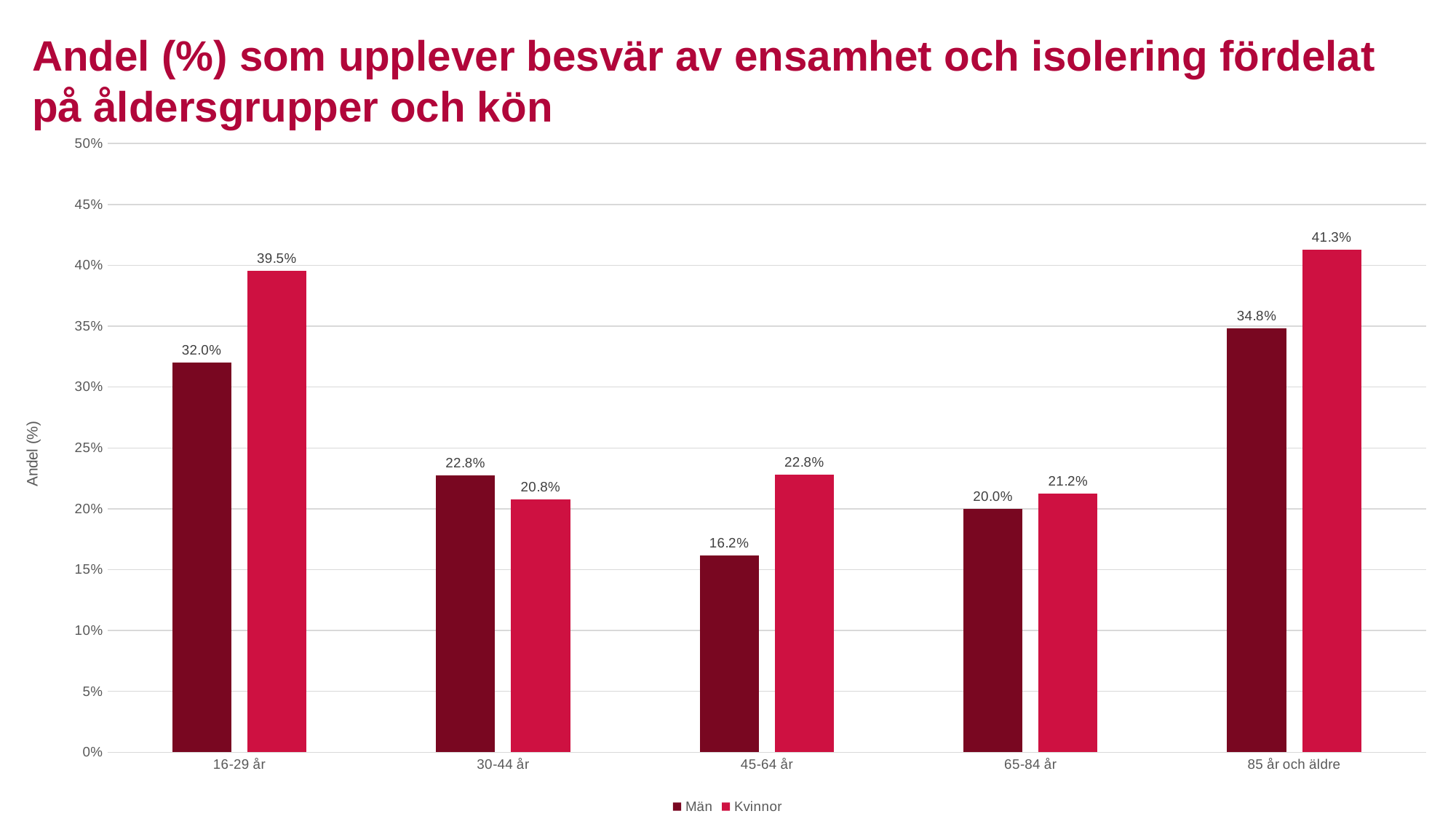
Which is larger in the 30-44 år age group, Män or Kvinnor? Män Which age group has the lowest value for Män? 45-64 år Which age group has the highest value for Kvinnor? 85 år och äldre What is the label of the y axis? Andel (%) How many age groups are shown on the x axis? 5 What is the value for Kvinnor in the 85 år och äldre age group? 41.3% What is the value for Män in the 16-29 år age group? 32.0% What kind of chart is shown on the slide? Bar chart How many series does the legend list? 2 What is the value for Kvinnor in the 45-64 år age group? 22.8% What is the difference between Kvinnor and Män in the 16-29 år age group? 7.5% Is the value for Män in the 85 år och äldre age group greater or less than 30%? greater